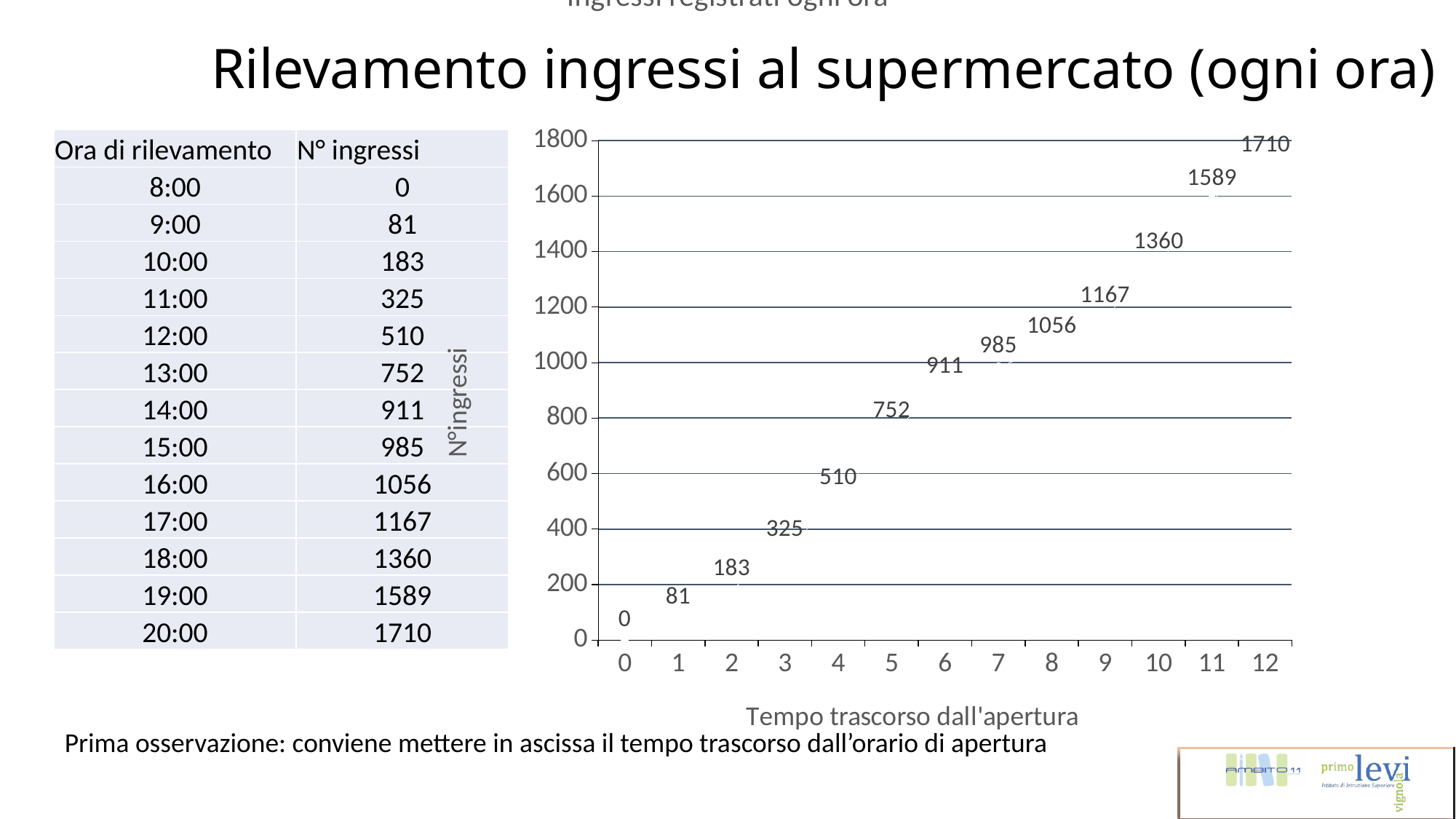
What is the value of N° ingressi at 2 hours after opening? 183 What is the label of the x axis of the chart? Tempo trascorso dall'apertura Which is larger: N° ingressi at 7 hours after opening or at 8 hours after opening? 8 hours after opening How many data points are plotted on the chart? 13 What is the value of N° ingressi at 5 hours after opening (Tempo trascorso dall'apertura = 5)? 752 At which value of Tempo trascorso dall'apertura is N° ingressi highest? 12 What is the lowest value of N° ingressi shown on the chart? 0 What is the difference in N° ingressi between 12 hours and 11 hours after opening? 121 What is the highest value of N° ingressi shown on the chart? 1710 What is the value of N° ingressi at 9 hours after opening? 1167 What is the difference in N° ingressi between 6 hours and 4 hours after opening? 401 Do the values of N° ingressi rise or fall as Tempo trascorso dall'apertura increases? rise